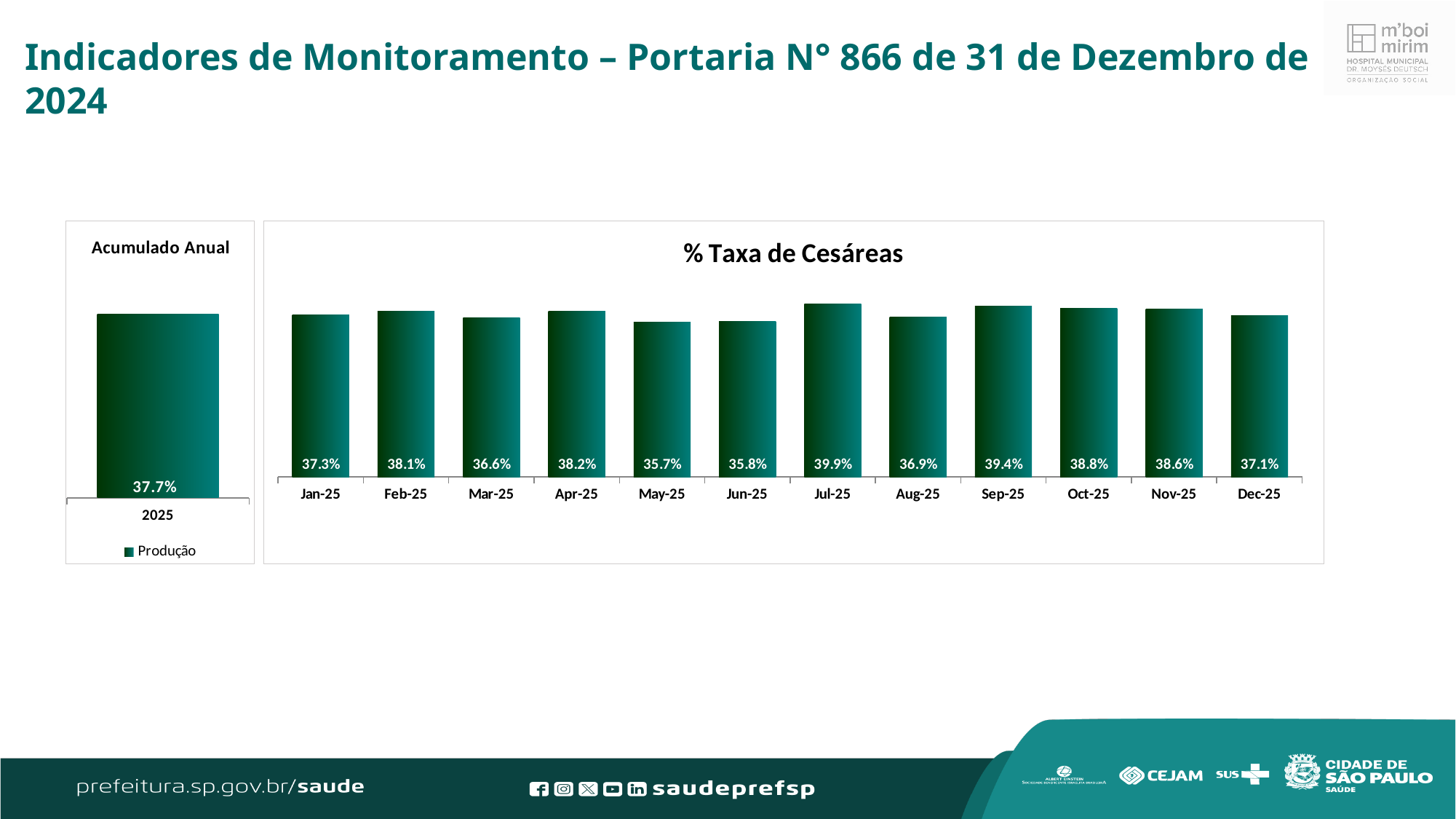
In the '% Taxa de Cesáreas' chart, what is the value for Jul-25? 39.9% What kind of chart is the '% Taxa de Cesáreas' chart? Bar chart How many months are shown in the '% Taxa de Cesáreas' chart? 12 In the '% Taxa de Cesáreas' chart, what is the value for Dec-25? 37.1% In the '% Taxa de Cesáreas' chart, which is larger, the value for Sep-25 or Aug-25? Sep-25 In the 'Acumulado Anual' chart, what series name does the legend show? Produção In the '% Taxa de Cesáreas' chart, what is the difference between the values for Jul-25 and May-25? 4.2 percentage points In the '% Taxa de Cesáreas' chart, which month has the highest value? Jul-25 In the '% Taxa de Cesáreas' chart, what is the value for Mar-25? 36.6% In the '% Taxa de Cesáreas' chart, which is larger, the value for Feb-25 or Mar-25? Feb-25 In the 'Acumulado Anual' chart, what is the value for 2025? 37.7% In the '% Taxa de Cesáreas' chart, which month has the lowest value? May-25